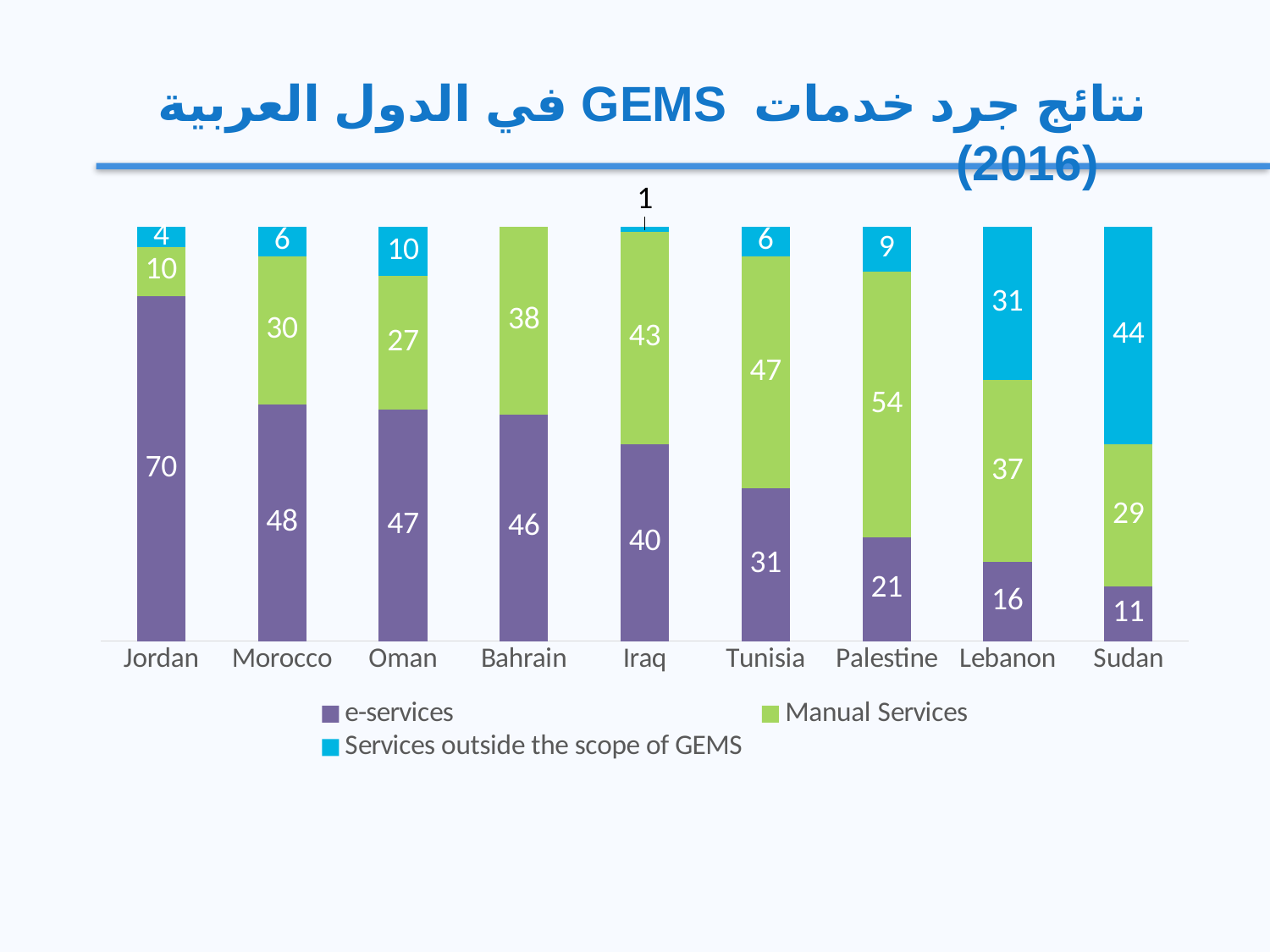
What is the total of the stacked bar for Lebanon? 84 What is the value of Services outside the scope of GEMS for Sudan? 44 What is the difference between the e-services values for Morocco and Oman? 1 What is the e-services value for Jordan? 70 Which country has the lowest e-services value? Sudan How many countries are shown on the x axis of the chart? 9 Which is larger, the Manual Services value for Iraq or for Tunisia? Tunisia How many series does the legend list? 3 What is the Manual Services value for Palestine? 54 What kind of chart is shown on the slide? Stacked bar chart Which series is shown in purple in the legend? e-services Which country has the highest e-services value? Jordan